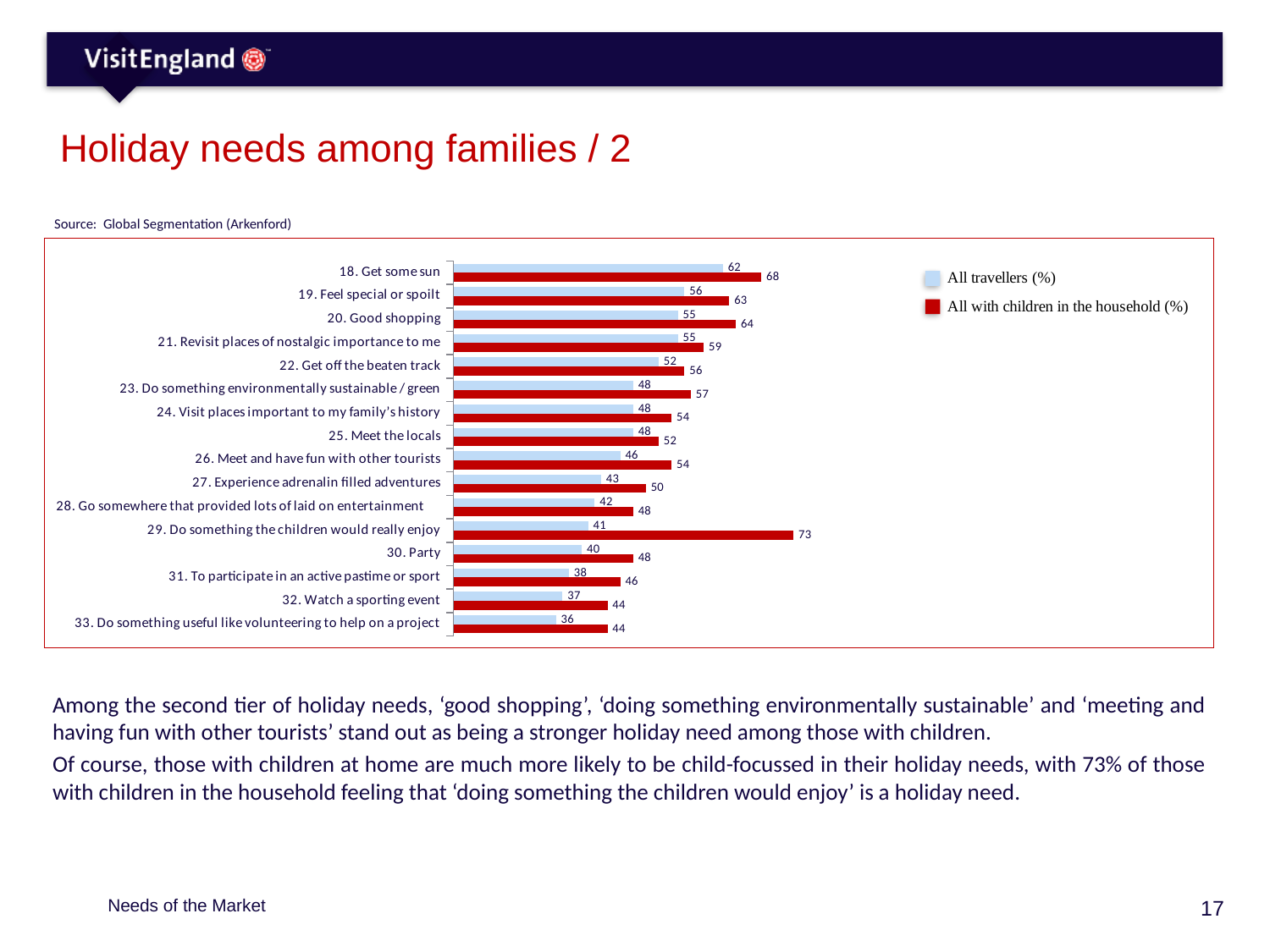
What colour are the bars for 'All with children in the household (%)'? Red Which category has the highest value for 'All with children in the household (%)'? 29. Do something the children would really enjoy Which is larger for '26. Meet and have fun with other tourists': the 'All travellers (%)' value or the 'All with children in the household (%)' value? All with children in the household (%) What is the value for 'All with children in the household (%)' for '29. Do something the children would really enjoy'? 73 What kind of chart is shown on the slide? Bar chart How many series does the legend list? 2 What is the value for 'All travellers (%)' for '20. Good shopping'? 55 Which category has the lowest value for 'All travellers (%)'? 33. Do something useful like volunteering to help on a project What is the value for 'All travellers (%)' for '18. Get some sun'? 62 What is the difference between the 'All with children in the household (%)' and 'All travellers (%)' values for '29. Do something the children would really enjoy'? 32 What is the difference between the 'All with children in the household (%)' and 'All travellers (%)' values for '20. Good shopping'? 9 How many categories are shown on the chart? 16